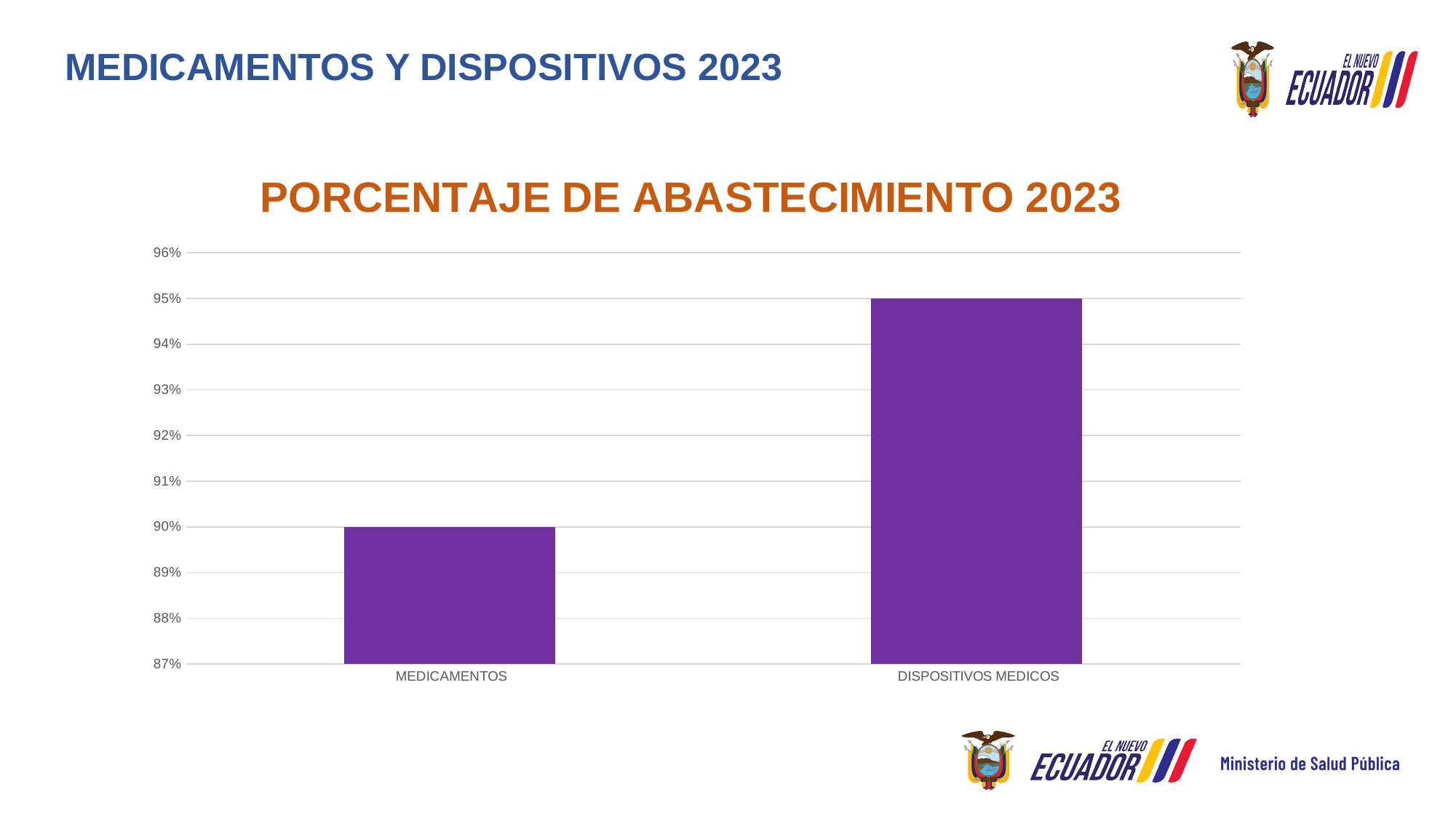
How many categories are shown in the chart? 2 Which category has the highest value? DISPOSITIVOS MEDICOS What colour are the bars in the chart? purple What kind of chart is shown on the slide? bar chart What is the value for MEDICAMENTOS? 90% Is the value for MEDICAMENTOS greater or less than 93%? less What is the difference between the values for DISPOSITIVOS MEDICOS and MEDICAMENTOS? 5% Is the value for DISPOSITIVOS MEDICOS greater or less than 92%? greater What is the title of the chart? PORCENTAJE DE ABASTECIMIENTO 2023 What is the value for DISPOSITIVOS MEDICOS? 95% Which is larger, the value for MEDICAMENTOS or the value for DISPOSITIVOS MEDICOS? DISPOSITIVOS MEDICOS Which category has the lowest value? MEDICAMENTOS